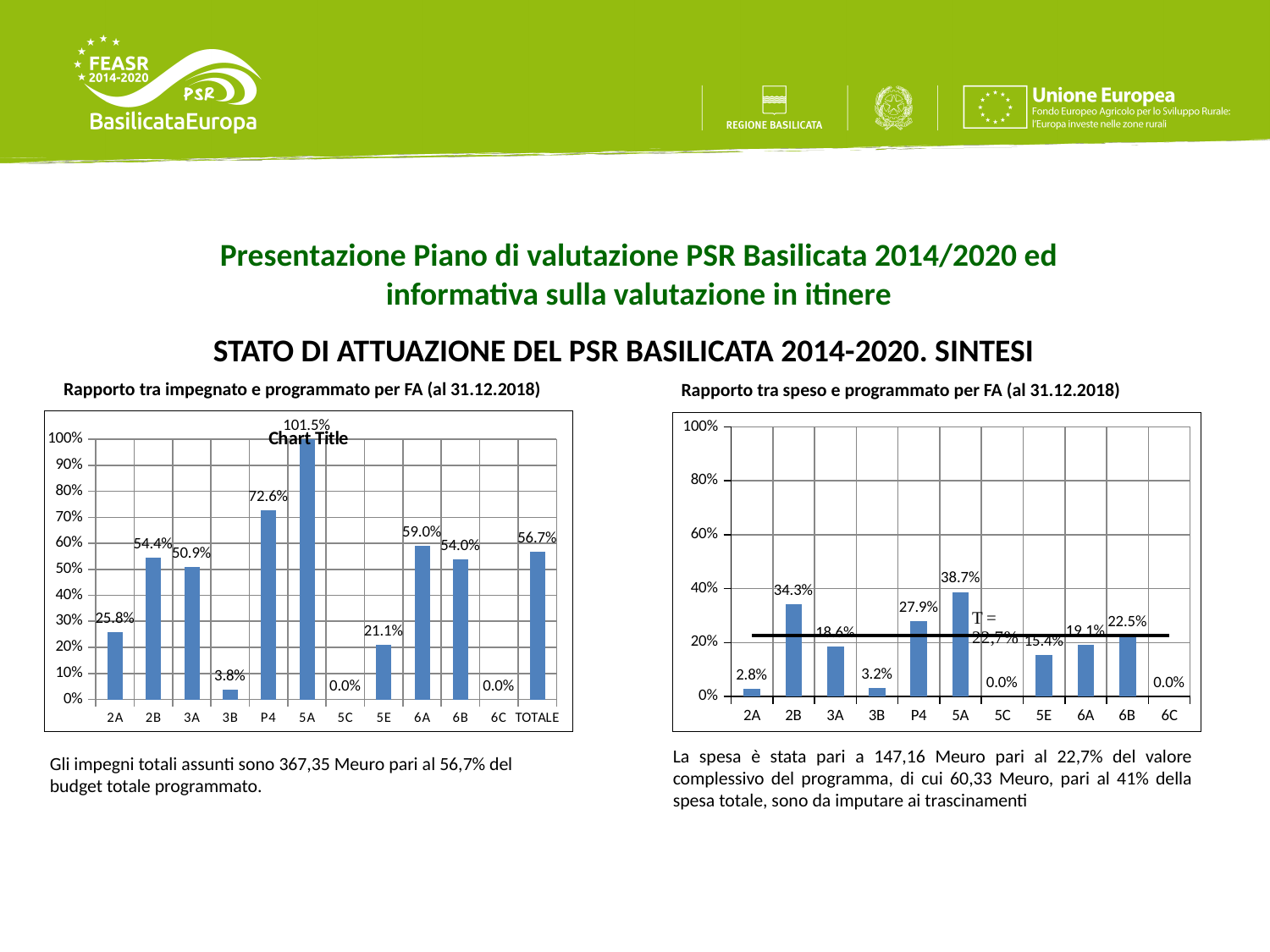
What type of chart is 'Rapporto tra speso e programmato per FA (al 31.12.2018)'? Bar chart In the chart 'Rapporto tra impegnato e programmato per FA (al 31.12.2018)', which category has the highest value? 5A In the chart 'Rapporto tra speso e programmato per FA (al 31.12.2018)', which category has the highest value? 5A In the chart 'Rapporto tra impegnato e programmato per FA (al 31.12.2018)', which is larger, the value for 2B or the value for 3A? 2B In the chart 'Rapporto tra speso e programmato per FA (al 31.12.2018)', what is the value for 2A? 2.8% In the chart 'Rapporto tra impegnato e programmato per FA (al 31.12.2018)', what is the difference between the values for 6A and 6B? 5.0% In the chart 'Rapporto tra impegnato e programmato per FA (al 31.12.2018)', what is the value for TOTALE? 56.7% In the chart 'Rapporto tra speso e programmato per FA (al 31.12.2018)', what value is the horizontal line labelled T set at? 22,7% In the chart 'Rapporto tra impegnato e programmato per FA (al 31.12.2018)', how many categories are shown on the x axis? 12 In the chart 'Rapporto tra impegnato e programmato per FA (al 31.12.2018)', what is the value for P4? 72.6% In the chart 'Rapporto tra speso e programmato per FA (al 31.12.2018)', what is the difference between the values for 2B and 3A? 15.7% In the chart 'Rapporto tra speso e programmato per FA (al 31.12.2018)', what is the value for 5A? 38.7%